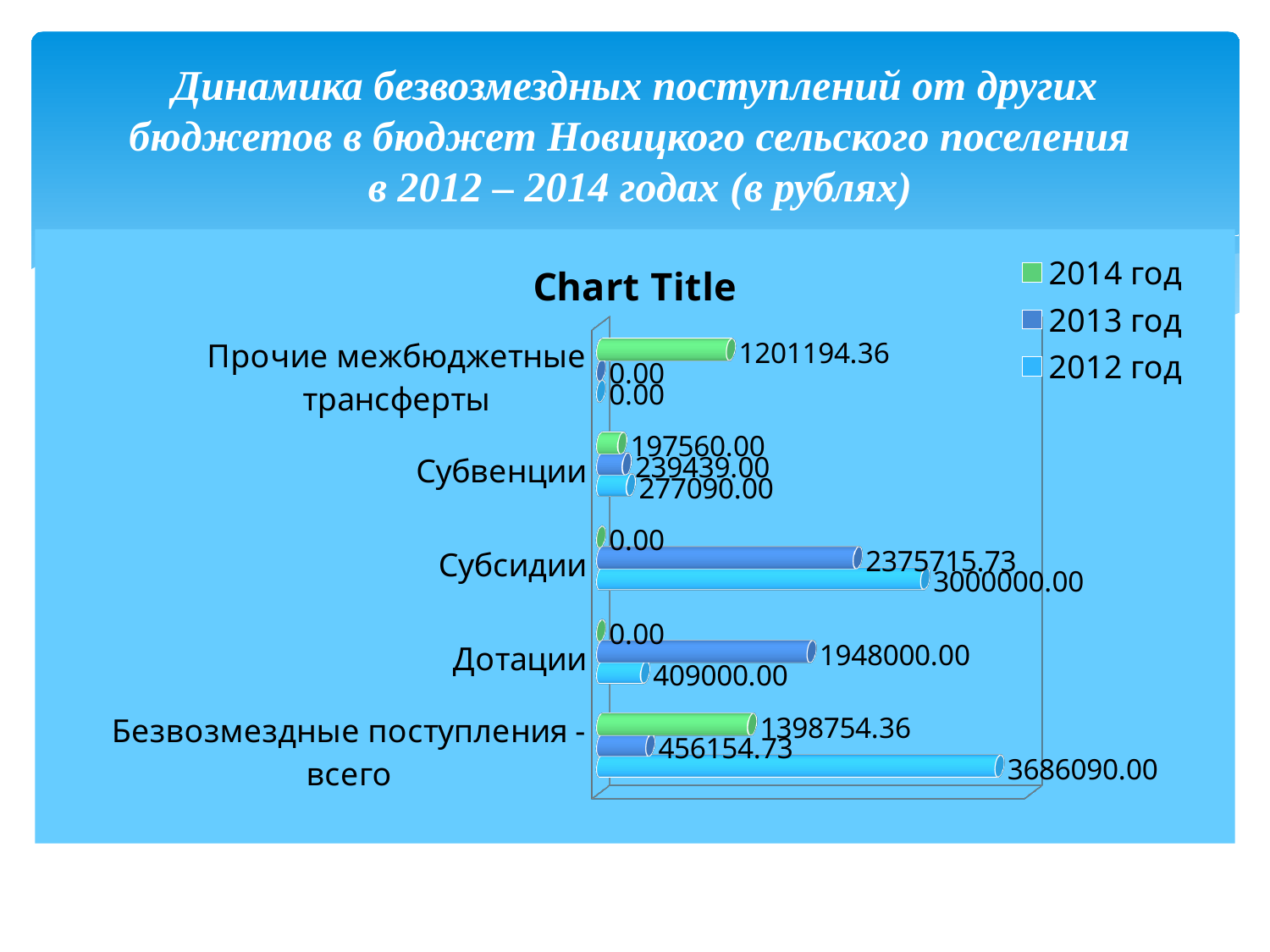
What is the difference between the 2012 год and 2014 год values for Субвенции? 79530.00 For Субсидии, which is larger: the 2012 год value or the 2013 год value? 2012 год How many series does the legend list? 3 What kind of chart is shown on the slide? Bar chart What is the value for Дотации in the 2013 год series? 1948000.00 How many categories are shown on the chart? 5 What is the value for Прочие межбюджетные трансферты in the 2014 год series? 1201194.36 Which category has the highest value in the 2012 год series? Безвозмездные поступления - всего Which category has the lowest value in the 2013 год series? Прочие межбюджетные трансферты What is the value for Субсидии in the 2012 год series? 3000000.00 What is the difference between the 2013 год and 2012 год values for Дотации? 1539000.00 What is the value for Безвозмездные поступления - всего in the 2012 год series? 3686090.00